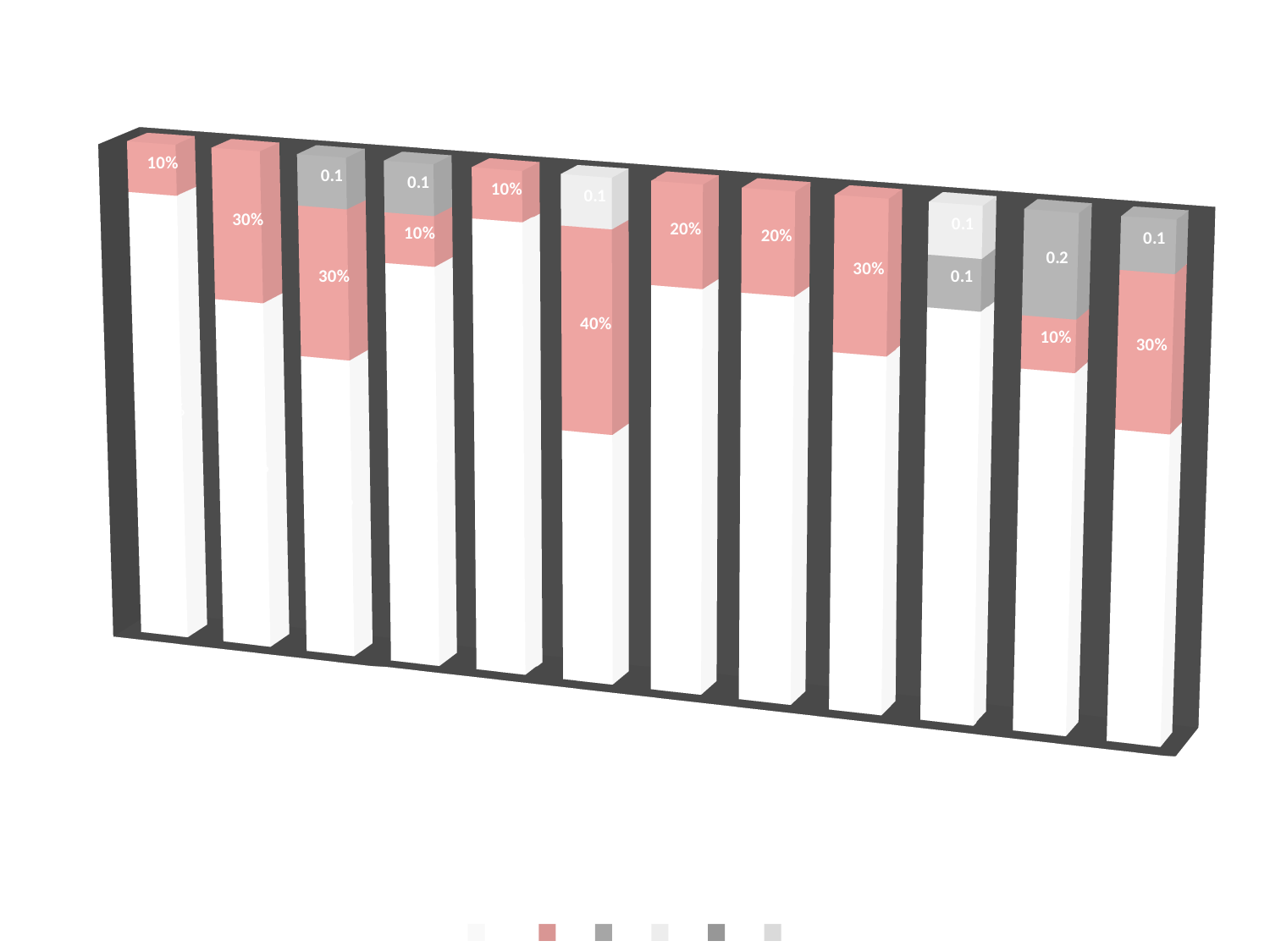
What is the difference between the pink segment of the sixth bar from the left (40%) and the pink segment of the fifth bar from the left (10%)? 30% Which bar has the largest pink segment? The sixth bar from the left (40%) What is the value labelled on the pink segment of the rightmost bar? 30% How many series does the legend list? 6 What is the value labelled on the pink segment of the second bar from the left? 30% What is the value labelled on the pink segment of the first bar from the left? 10% What is the value labelled on the pink segment of the sixth bar from the left? 40% Which is larger: the pink segment of the second bar from the left or the pink segment of the first bar from the left? The second bar (30%) Do the legend entries have text labels? No How many bars are plotted in the chart? 12 What is the value labelled on the dark grey segment of the eleventh bar from the left? 0.2 What kind of chart is shown on the slide? Stacked bar chart